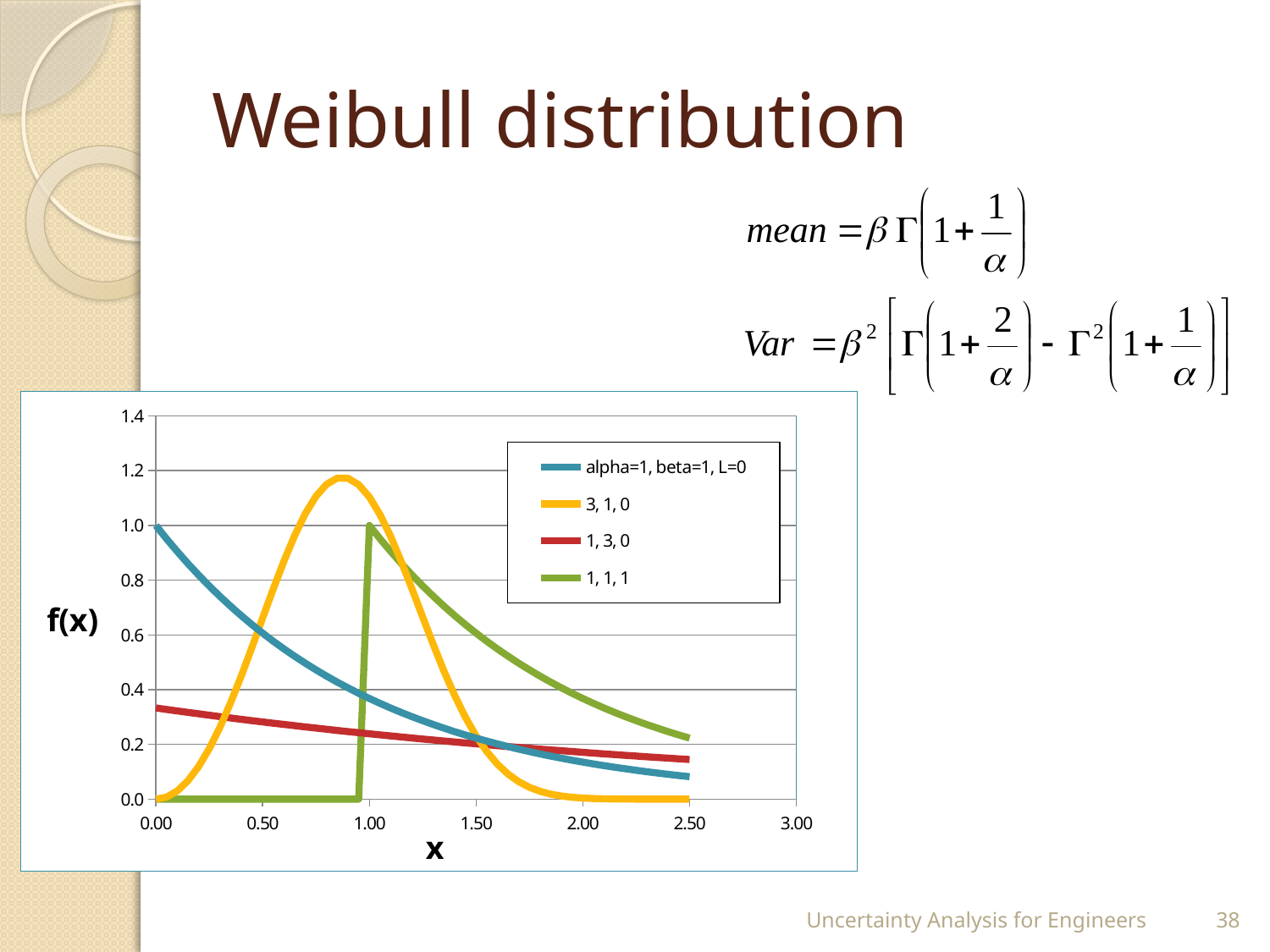
What is the value of the '1, 1, 1' series at x = 0.50? 0.0 What is the value of the 'alpha=1, beta=1, L=0' series at x = 0.00? 1.0 What is the label on the vertical axis of the chart? f(x) Is the value of the '1, 3, 0' series at x = 0.00 greater or less than 0.4? less How many series does the chart legend list? 4 Is the peak value of the '3, 1, 0' series greater or less than 1.0? greater At x = 0.50, which series has the larger value: 'alpha=1, beta=1, L=0' or '1, 3, 0'? alpha=1, beta=1, L=0 Is the value of the 'alpha=1, beta=1, L=0' series at x = 2.50 greater or less than 0.2? less Which series reaches the highest peak value on the chart? 3, 1, 0 What is the label of the first series in the legend? alpha=1, beta=1, L=0 What kind of chart is shown on the slide? line chart Does the 'alpha=1, beta=1, L=0' series rise or fall as x increases? fall